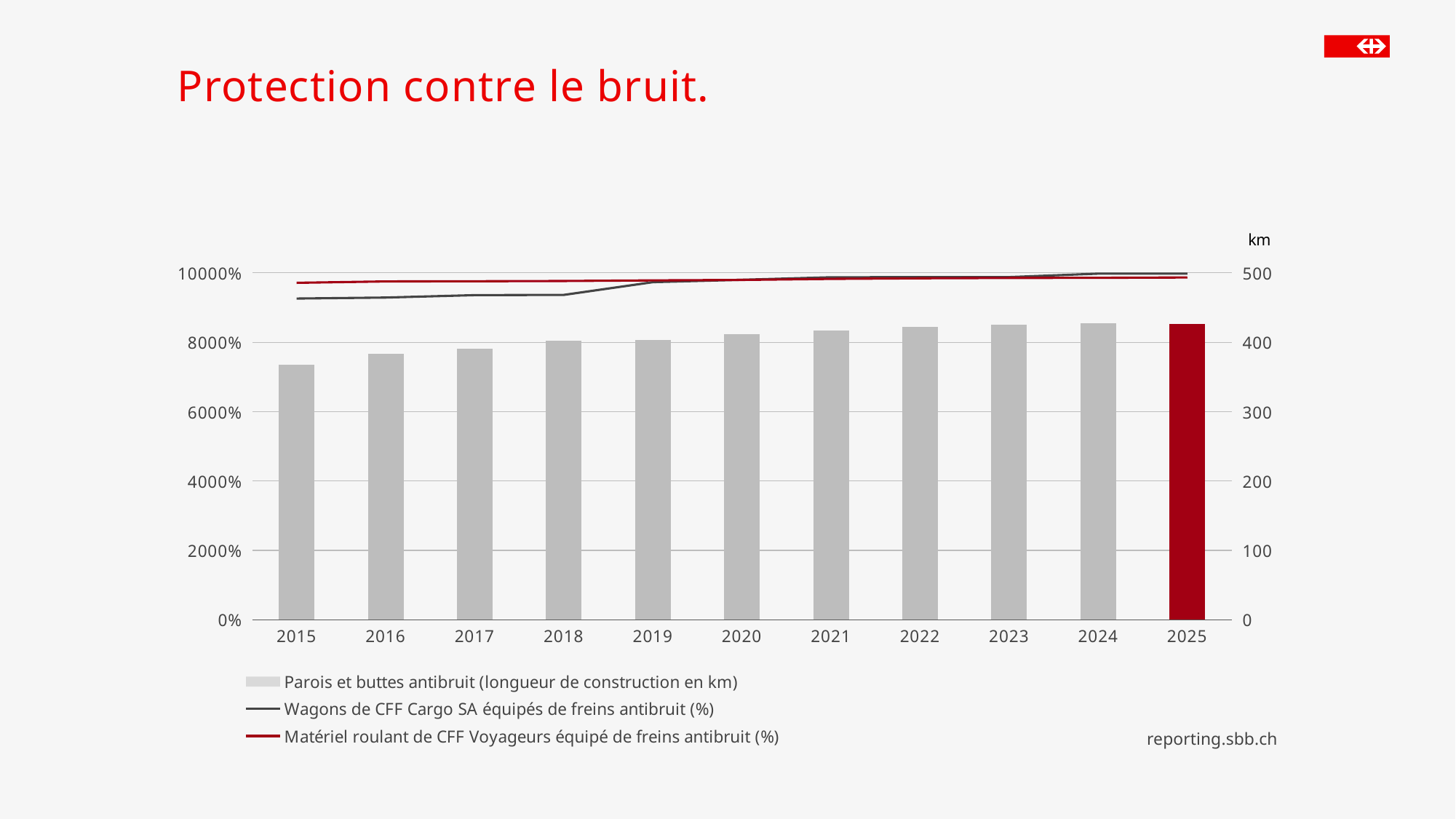
Which year's bar is shown in red instead of grey? 2025 How many series does the chart legend list? 3 Is the 2021 value for 'Parois et buttes antibruit' greater or less than 300 km? greater What is the title of the slide containing the chart? Protection contre le bruit. Do the values for 'Parois et buttes antibruit' generally rise or fall from 2015 to 2025? rise Which year has the lowest value for 'Parois et buttes antibruit (longueur de construction en km)'? 2015 Does the line for 'Wagons de CFF Cargo SA équipés de freins antibruit (%)' rise or fall from 2015 to 2025? rise What kind of chart is shown on the slide? Combined bar and line chart How many years are shown on the x axis of the chart? 11 In 2015, which line is higher: 'Wagons de CFF Cargo SA équipés de freins antibruit (%)' or 'Matériel roulant de CFF Voyageurs équipé de freins antibruit (%)'? Matériel roulant de CFF Voyageurs équipé de freins antibruit (%) Is the 2025 value for 'Parois et buttes antibruit' greater or less than 400 km? greater Is the 2015 value for 'Parois et buttes antibruit' greater or less than 400 km? less